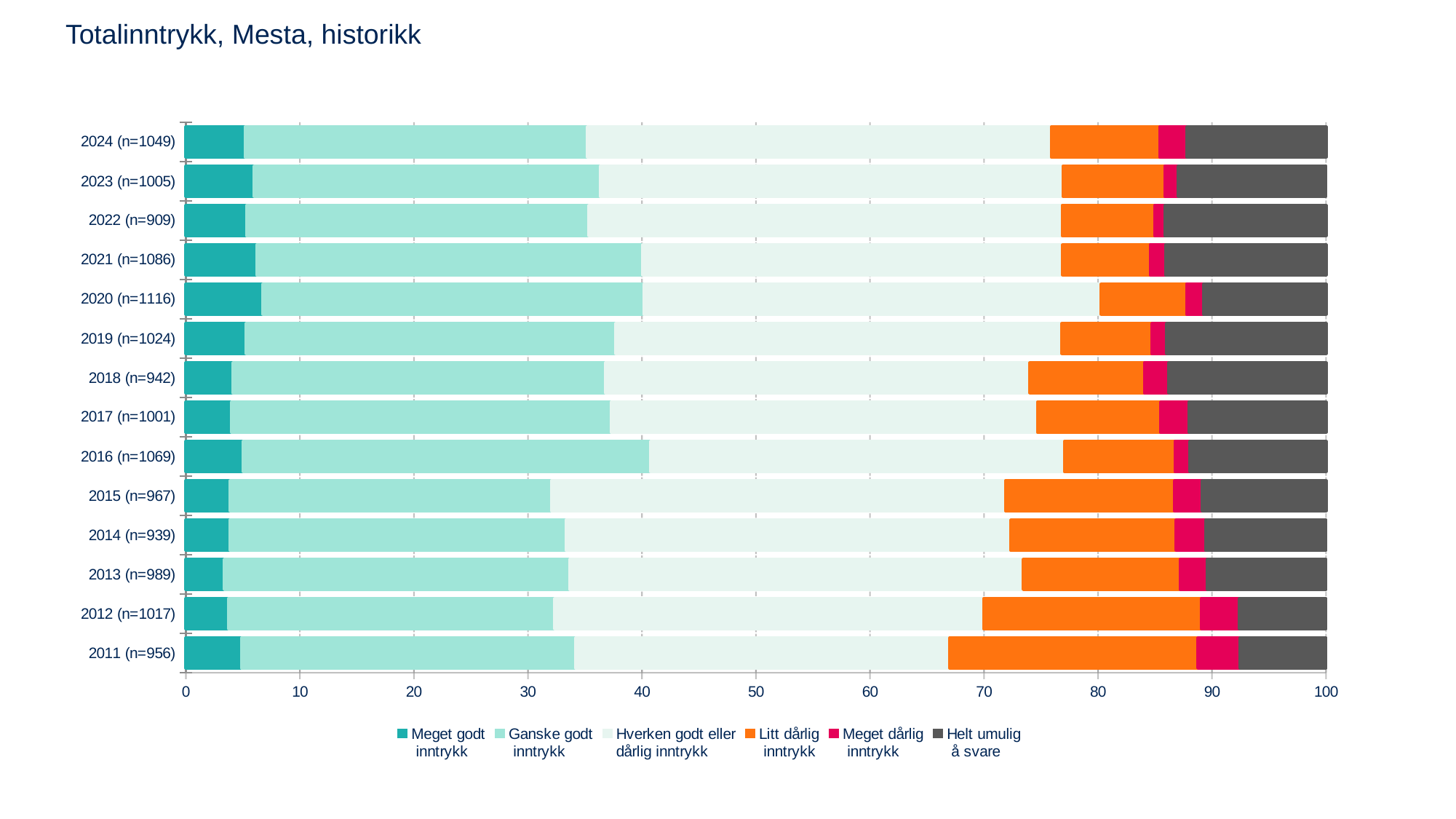
How many years (categories) are plotted on the chart? 14 What sample size is given for 2024 in its category label? n=1049 Which year has the largest 'Litt dårlig inntrykk' segment? 2011 (n=956) What is the title of the chart? Totalinntrykk, Mesta, historikk Is the 'Litt dårlig inntrykk' segment larger for 2011 or for 2023? 2011 Does the 'Litt dårlig inntrykk' segment for 2011 start at a value greater or less than 70? less What kind of chart is shown on the slide? Stacked bar chart Is the 'Helt umulig å svare' segment for 2011 greater or less than 10 percentage points wide? less How many series does the legend list? 6 Is the 'Ganske godt inntrykk' segment larger for 2016 or for 2015? 2016 Is the combined share of 'Meget godt inntrykk' and 'Ganske godt inntrykk' for 2015 greater or less than 40? less Does the 'Litt dårlig inntrykk' segment generally grow or shrink from 2011 to 2024? shrink